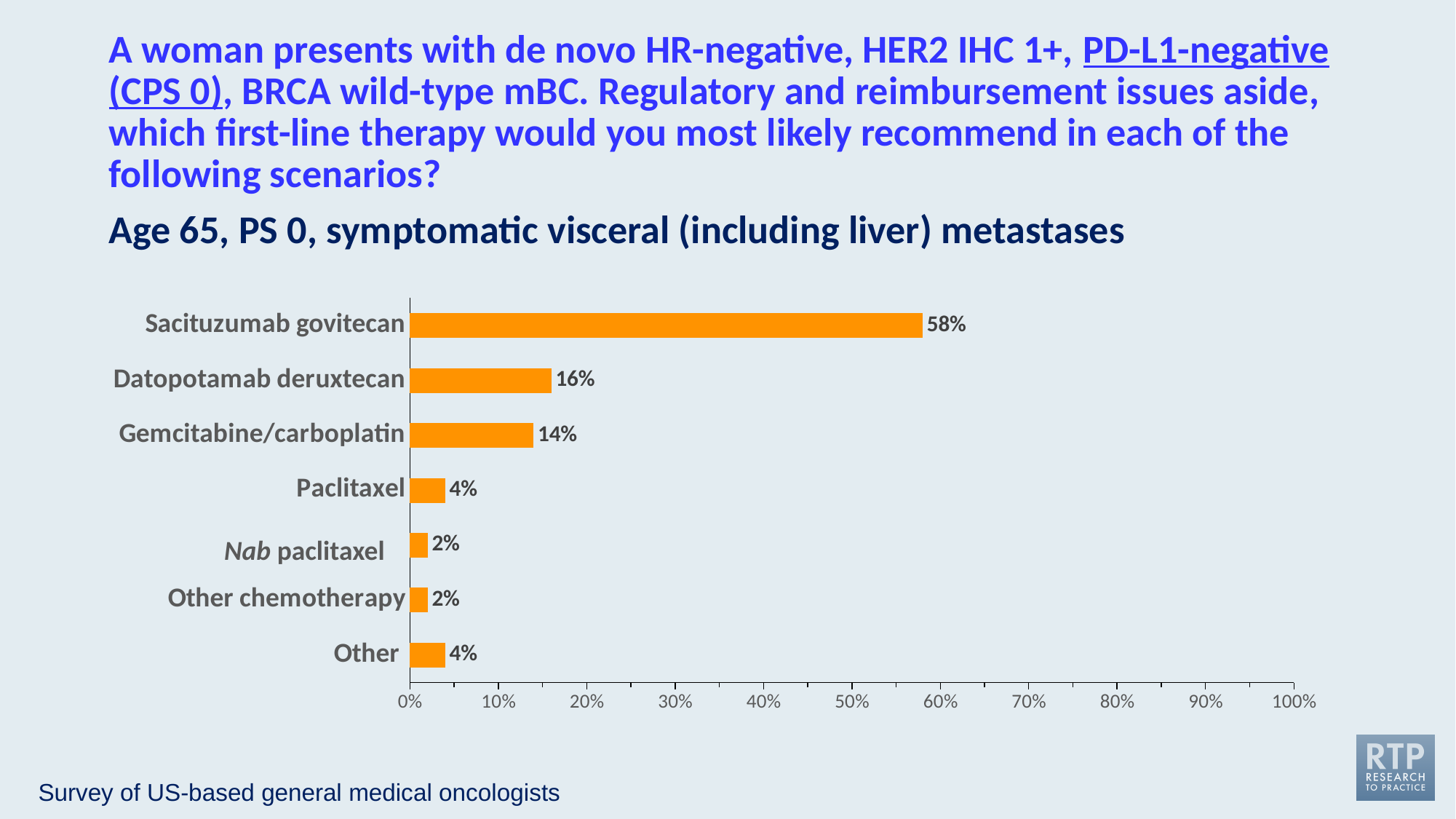
What percentage of respondents chose Sacituzumab govitecan? 58% What percentage of respondents chose Gemcitabine/carboplatin? 14% What is the difference in percentage points between Sacituzumab govitecan and Datopotamab deruxtecan? 42 What is the maximum value shown on the x axis? 100% What percentage of respondents chose Datopotamab deruxtecan? 16% Which has a larger percentage, Paclitaxel or Nab paclitaxel? Paclitaxel How many therapy categories are shown in the chart? 7 What percentage of respondents chose Nab paclitaxel? 2% Which therapy has the highest percentage? Sacituzumab govitecan Is the value for Sacituzumab govitecan greater or less than 50%? greater What is the difference in percentage points between Datopotamab deruxtecan and Gemcitabine/carboplatin? 2 What kind of chart is shown on the slide? Bar chart